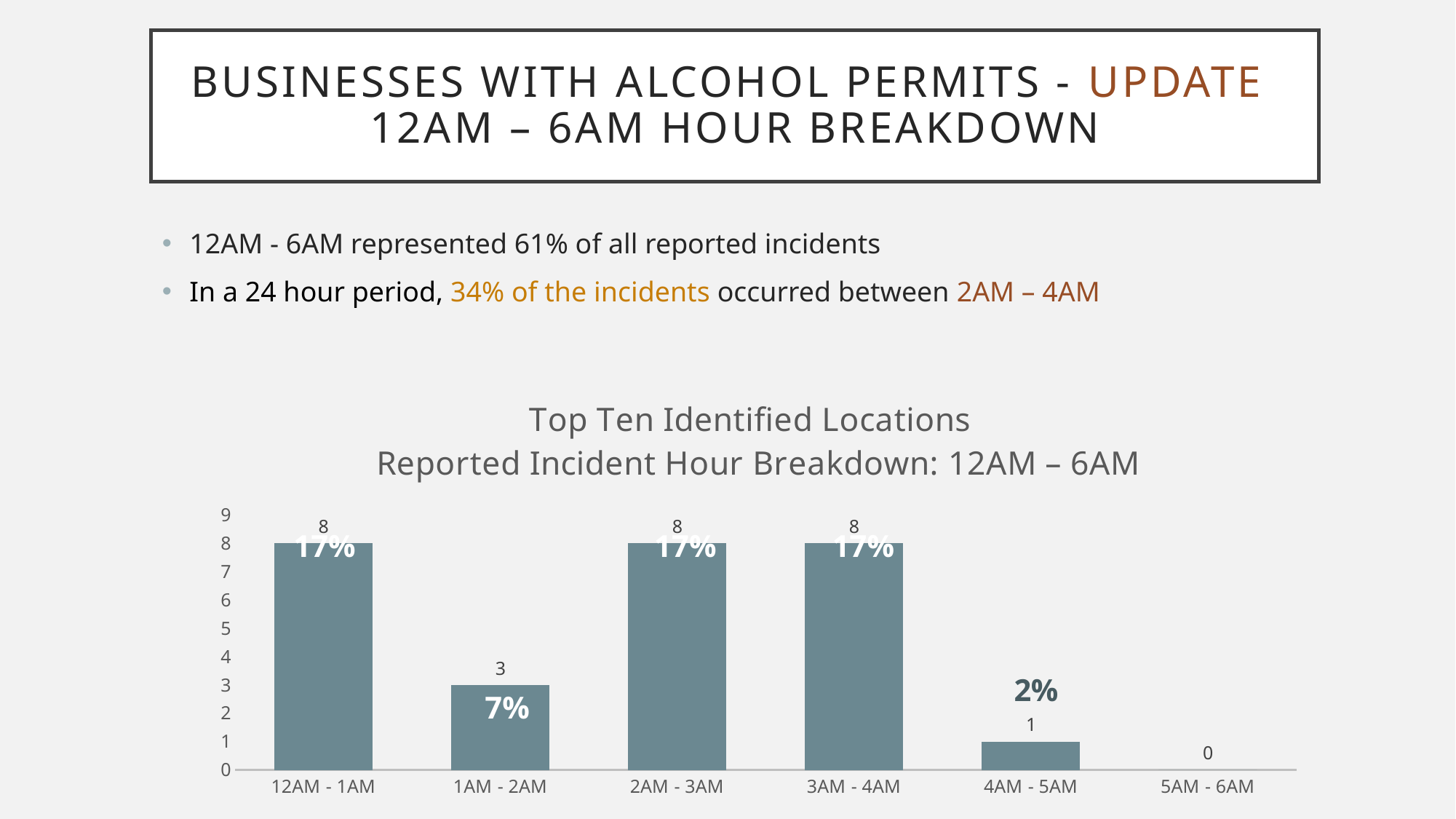
What is the total of the values for 2AM - 3AM and 3AM - 4AM? 16 Which is larger, the value for 3AM - 4AM or the value for 4AM - 5AM? 3AM - 4AM What is the value for 4AM - 5AM? 1 What is the value for 1AM - 2AM? 3 How many hour categories are shown on the x axis? 6 What percentage label is shown on the 1AM - 2AM bar? 7% What kind of chart is shown? bar chart What is the value for 12AM - 1AM? 8 What is the title of the chart? Top Ten Identified Locations Reported Incident Hour Breakdown: 12AM – 6AM What is the difference between the values for 2AM - 3AM and 1AM - 2AM? 5 What is the value for 5AM - 6AM? 0 Which hour has the lowest value? 5AM - 6AM